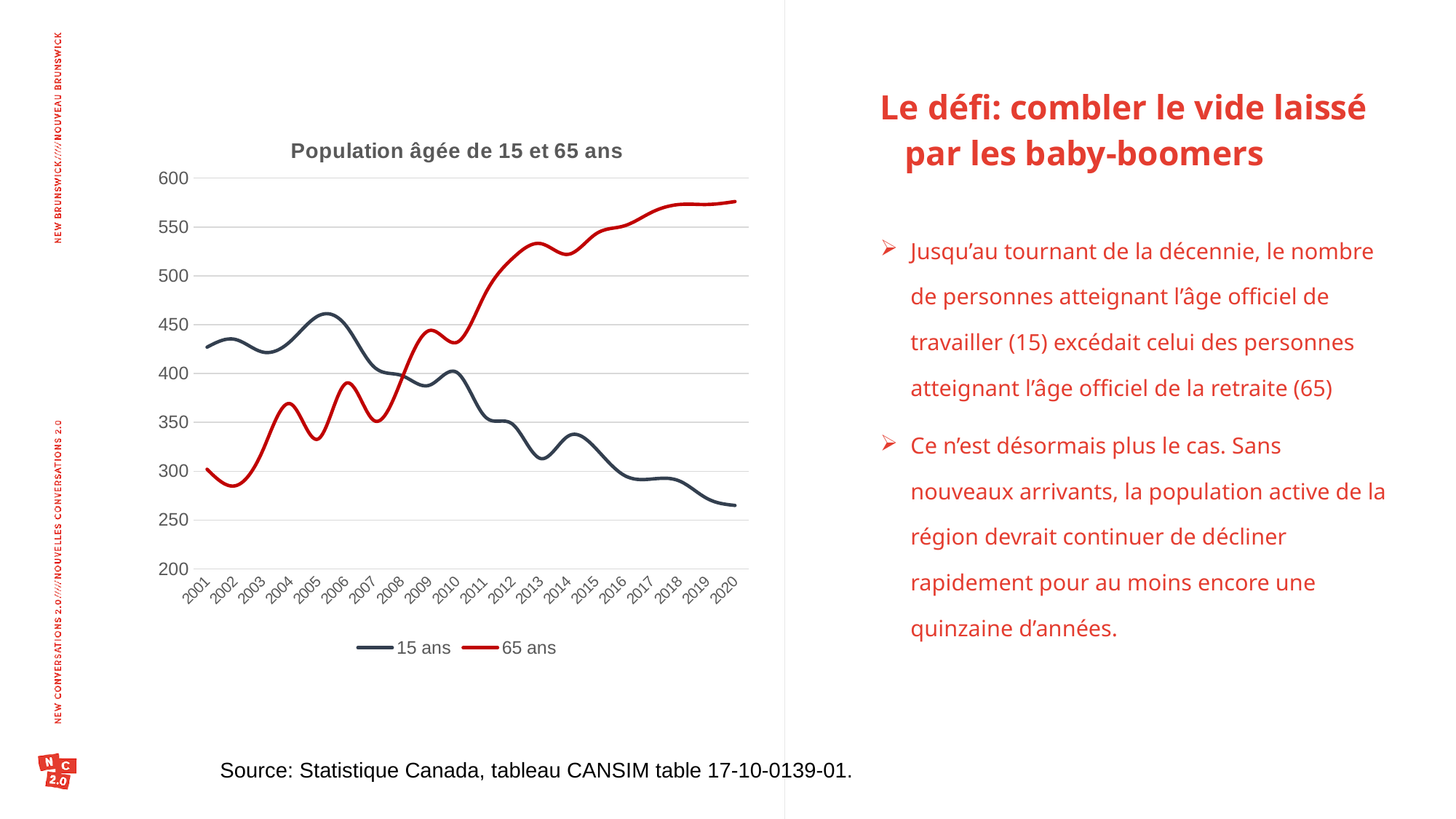
Does the 65 ans series rise or fall overall from 2001 to 2020? rise Does the 15 ans series rise or fall overall from 2001 to 2020? fall What kind of chart is shown on the slide? line chart What is the title of the chart? Population âgée de 15 et 65 ans Is the value for 15 ans in 2001 greater or less than 400? greater In 2001, which series has the larger value, 15 ans or 65 ans? 15 ans In 2020, which series has the larger value, 15 ans or 65 ans? 65 ans How many years are shown on the x axis of the chart? 20 Is the value for 65 ans in 2020 greater or less than 550? greater Is the value for 15 ans in 2020 greater or less than 300? less Which series is drawn in red? 65 ans How many series does the legend list? 2